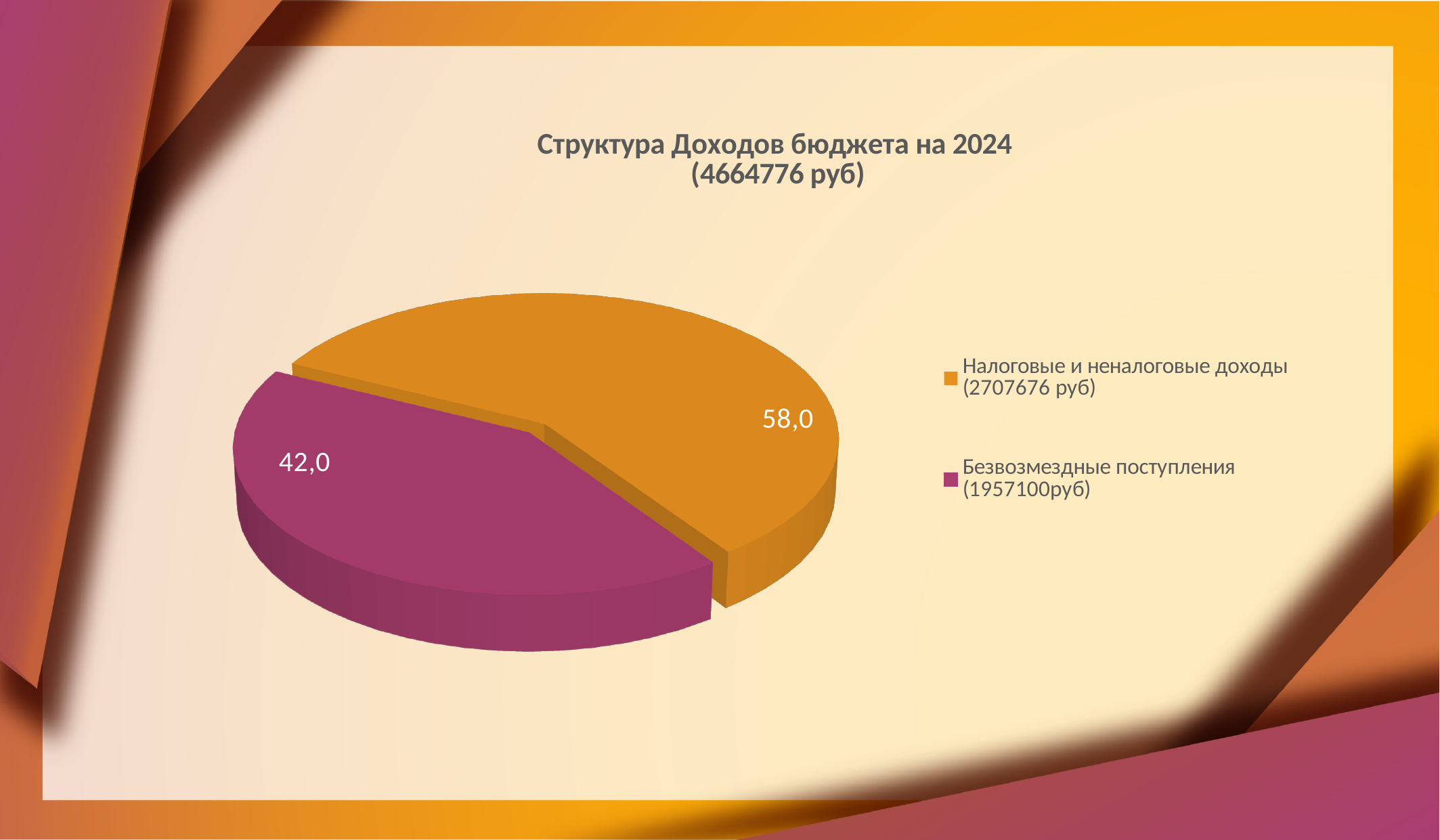
What is the title of the chart? Структура Доходов бюджета на 2024 (4664776 руб) What kind of chart is shown on the slide? Pie chart Which is larger: 'Налоговые и неналоговые доходы' or 'Безвозмездные поступления'? Налоговые и неналоговые доходы What is the total of the two slice values shown on the pie chart? 100,0 What is the difference between the values for 'Налоговые и неналоговые доходы' and 'Безвозмездные поступления'? 16,0 What value is shown for the slice 'Налоговые и неналоговые доходы (2707676 руб)'? 58,0 What colour is the slice for 'Безвозмездные поступления (1957100руб)'? Purple (magenta) Which slice is the smallest? Безвозмездные поступления (1957100руб) How many slices does the pie chart have? 2 Which slice is the largest? Налоговые и неналоговые доходы (2707676 руб) What value is shown for the slice 'Безвозмездные поступления (1957100руб)'? 42,0 How many entries does the legend list? 2